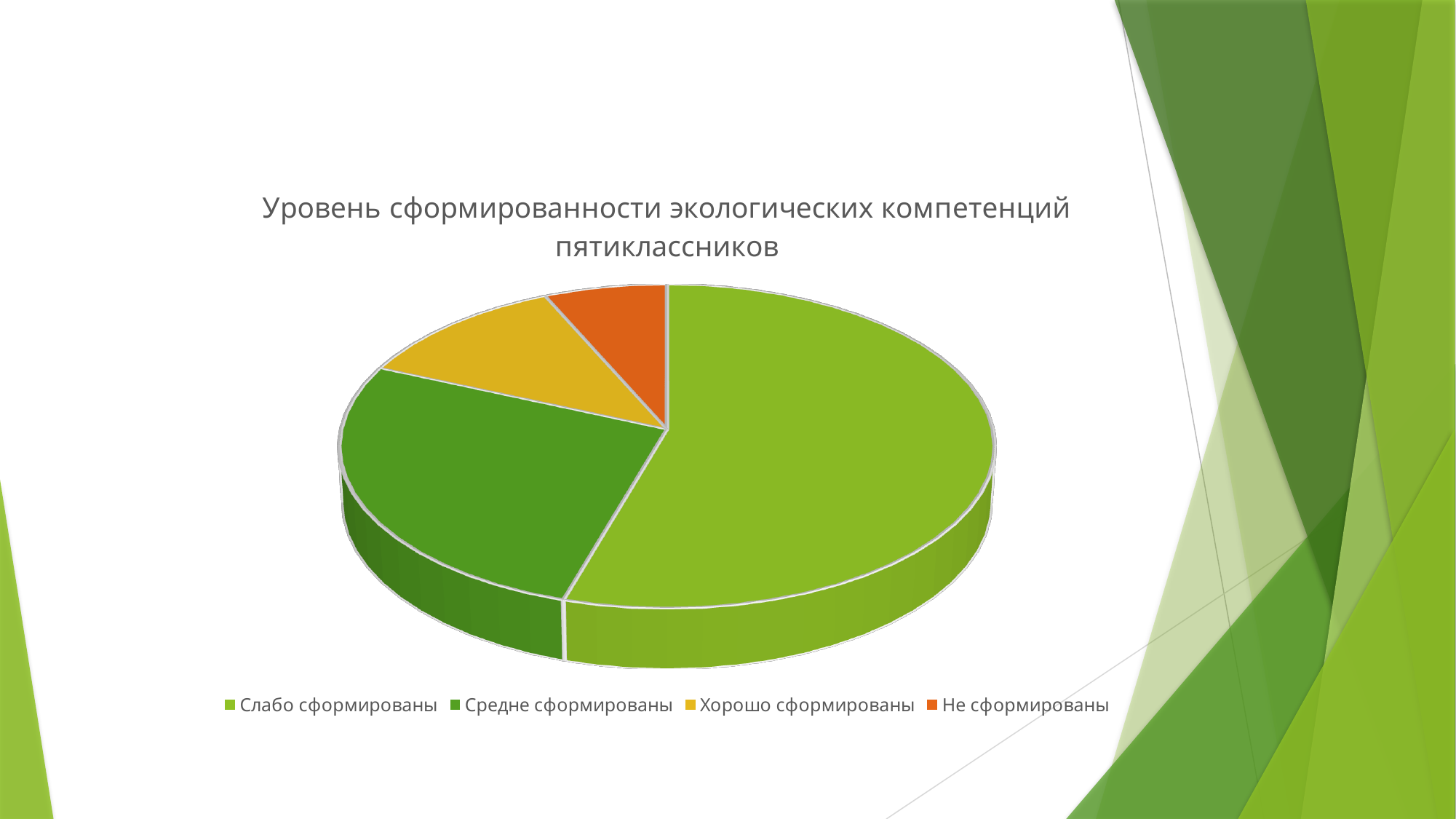
Does the slice for Слабо сформированы take up more or less than half of the pie? more Which slice is larger: Хорошо сформированы or Не сформированы? Хорошо сформированы What is the title of the chart? Уровень сформированности экологических компетенций пятиклассников How many entries does the legend list? 4 How many slices does the pie chart have? 4 Which slice is larger: Средне сформированы or Хорошо сформированы? Средне сформированы What kind of chart is shown on the slide? Pie chart Which slice is larger: Слабо сформированы or Средне сформированы? Слабо сформированы Which category has the smallest slice of the pie? Не сформированы What colour is the slice for Не сформированы? Orange Which category has the largest slice of the pie? Слабо сформированы